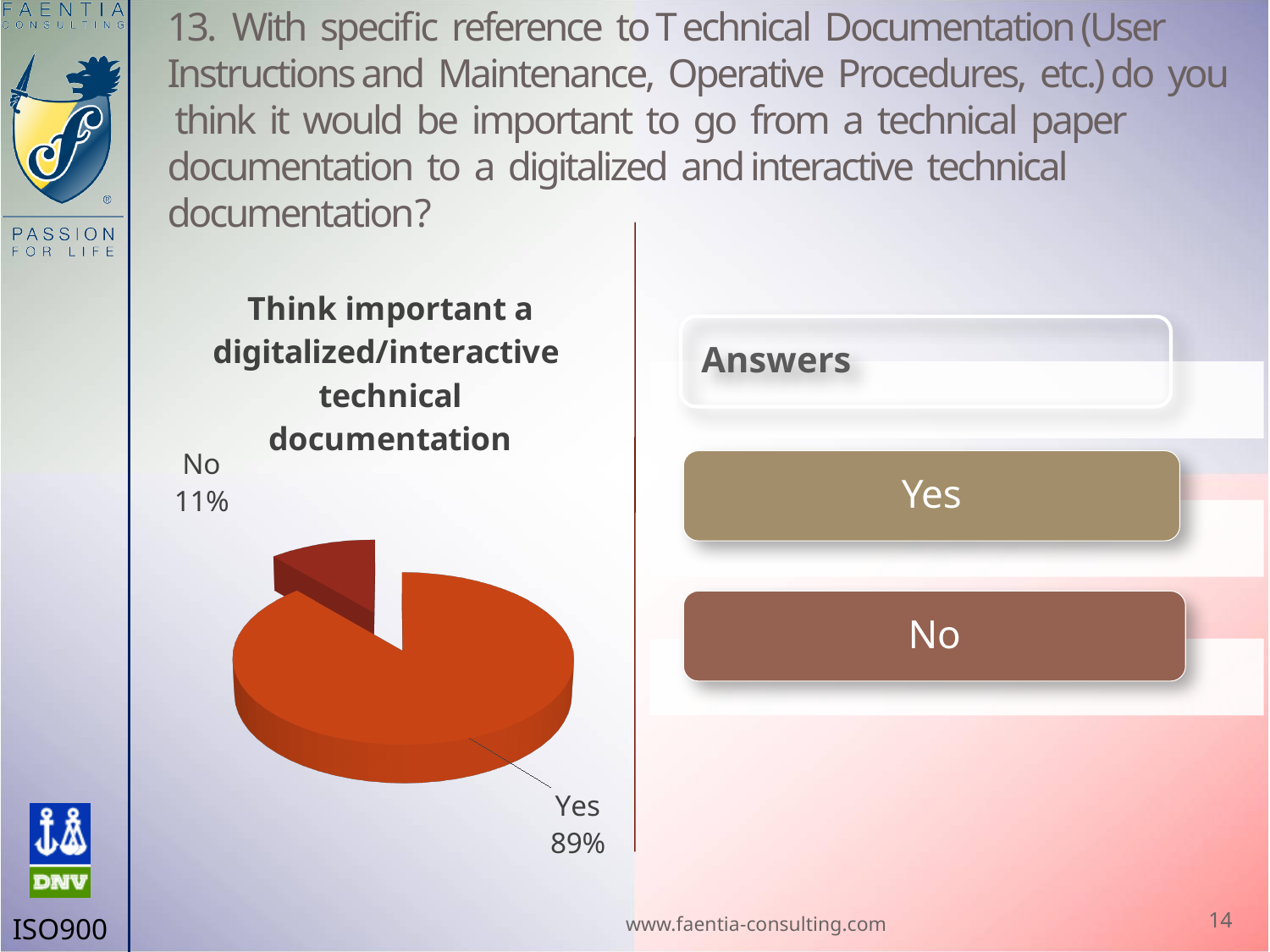
What share of the pie does the "No" slice represent? 11% What is the difference in percentage points between the "Yes" and "No" slices? 78 Which slice of the pie is the largest? Yes How many slices does the pie chart have? 2 What share of the pie does the "Yes" slice represent? 89% Which slice of the pie is pulled out (exploded) from the rest? No Which slice of the pie is the smallest? No What kind of chart is shown on the slide? pie chart Which is larger, the "Yes" slice or the "No" slice? Yes What is the title of the pie chart? Think important a digitalized/interactive technical documentation